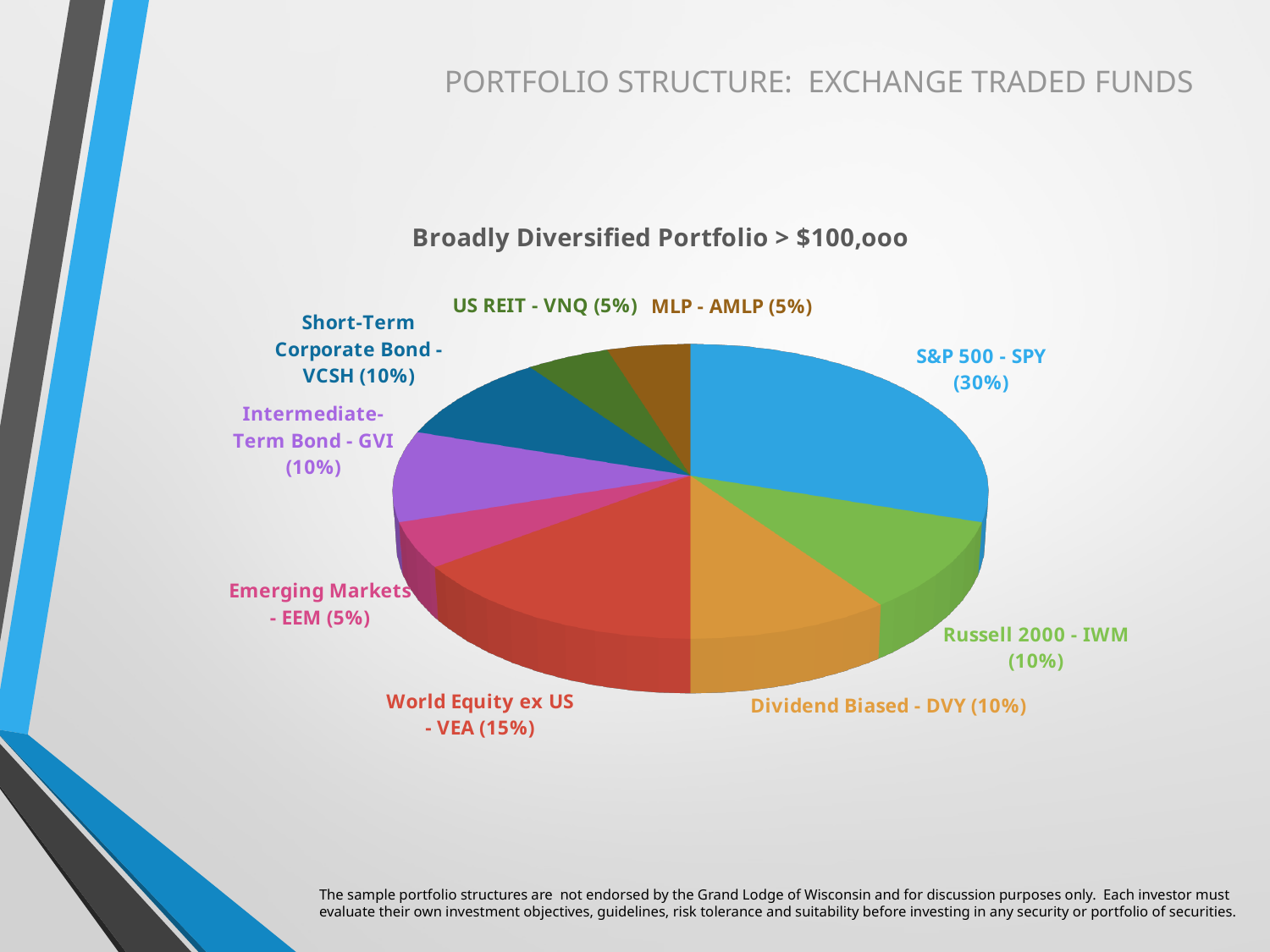
What is the difference in percentage points between S&P 500 - SPY and World Equity ex US - VEA? 15 What type of chart is shown on the slide? pie chart What share of the portfolio is allocated to S&P 500 - SPY? 30% What share of the portfolio is allocated to MLP - AMLP? 5% Which slice has the largest share of the portfolio? S&P 500 - SPY What share of the portfolio is allocated to Intermediate-Term Bond - GVI? 10% What share of the portfolio is allocated to Emerging Markets - EEM? 5% What is the combined share of Short-Term Corporate Bond - VCSH and Intermediate-Term Bond - GVI? 20% What share of the portfolio is allocated to World Equity ex US - VEA? 15% Which has a larger share, Russell 2000 - IWM or US REIT - VNQ? Russell 2000 - IWM How many slices does the pie chart have? 9 What is the title of the chart? Broadly Diversified Portfolio > $100,ooo